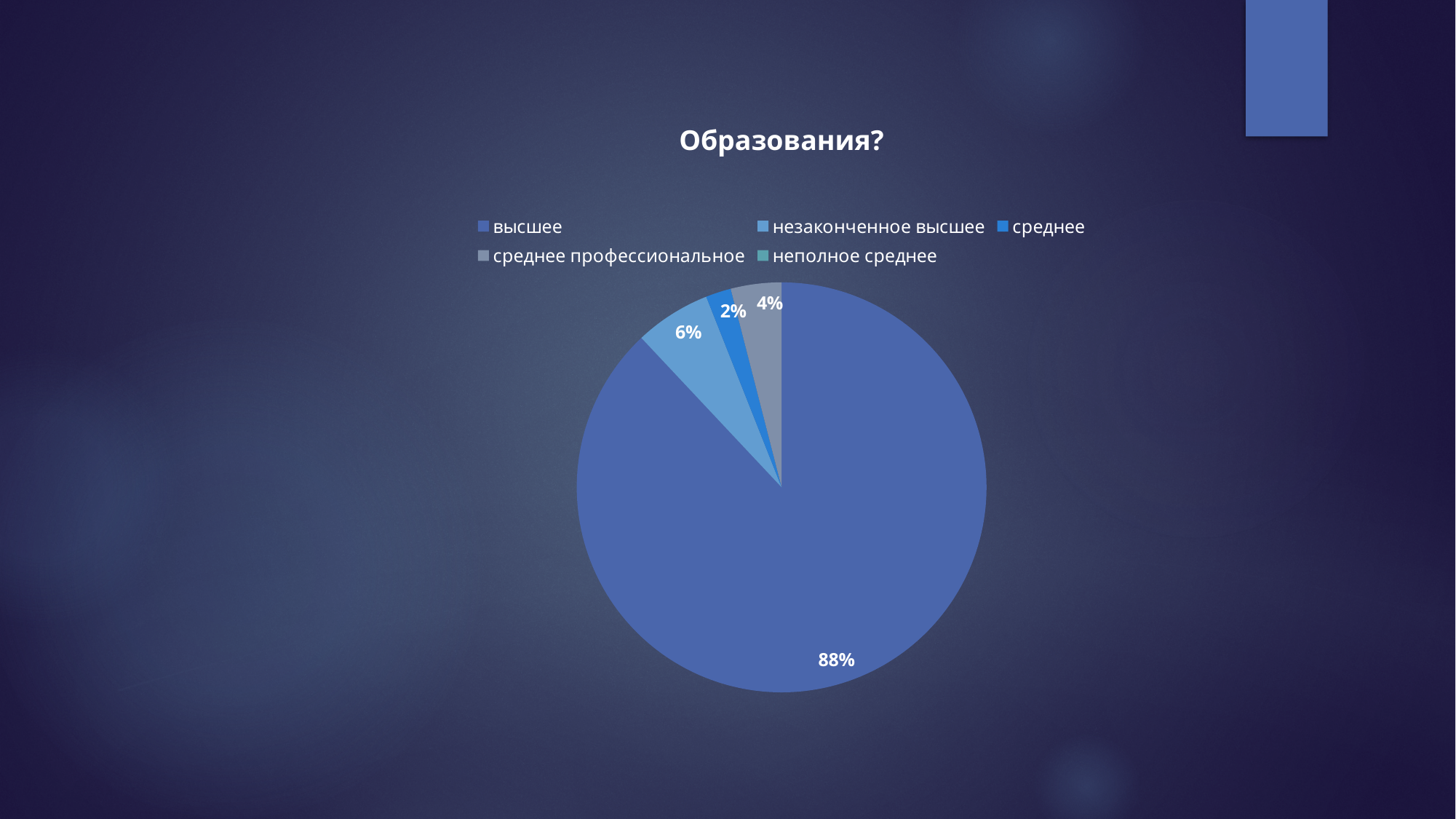
What percentage is shown for незаконченное высшее? 6% What percentage is shown for среднее? 2% What percentage of the pie chart is labelled for высшее? 88% What is the difference in percentage points between высшее and незаконченное высшее? 82 What percentage is shown for среднее профессиональное? 4% How many categories does the legend list? 5 What type of chart is shown on the slide? pie chart Which of the labelled slices is the smallest? среднее Which category has the largest slice of the pie? высшее Which is larger, the slice for среднее профессиональное or the slice for среднее? среднее профессиональное Which legend entry has no visible labelled slice in the pie? неполное среднее What is the title of the chart? Образования?